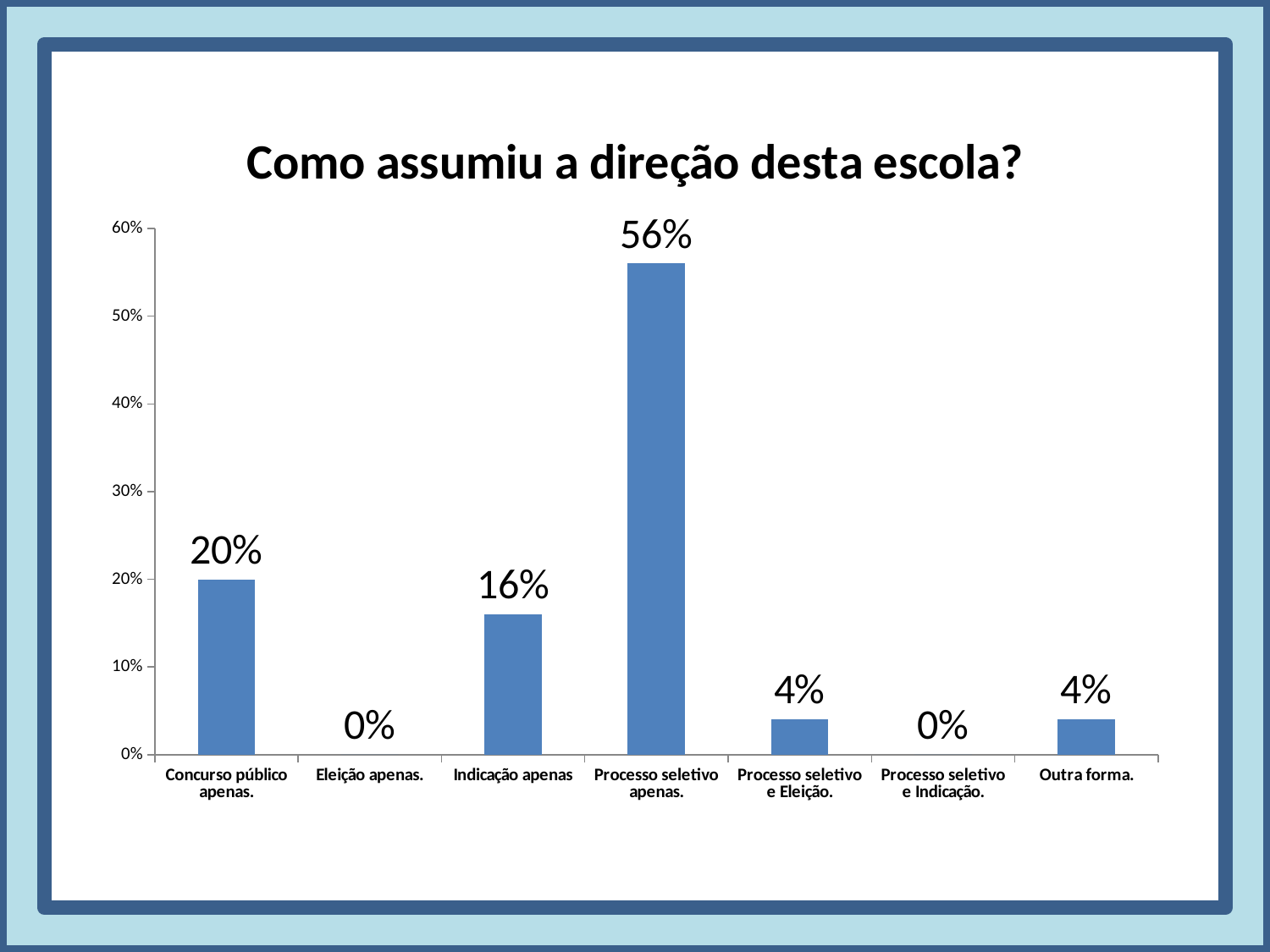
What is the title of the chart? Como assumiu a direção desta escola? What is the value for "Processo seletivo e Eleição."? 4% What is the value for "Concurso público apenas."? 20% What kind of chart is shown on the slide? bar chart How many categories are shown on the x axis? 7 Is the value for "Processo seletivo apenas." greater or less than 50%? greater What is the value for "Indicação apenas"? 16% What is the difference between the values for "Processo seletivo apenas." and "Concurso público apenas."? 36% Which category has the highest value? Processo seletivo apenas. Which is larger, the value for "Concurso público apenas." or the value for "Indicação apenas"? Concurso público apenas. What is the value for "Processo seletivo apenas."? 56% What is the value for "Eleição apenas."? 0%